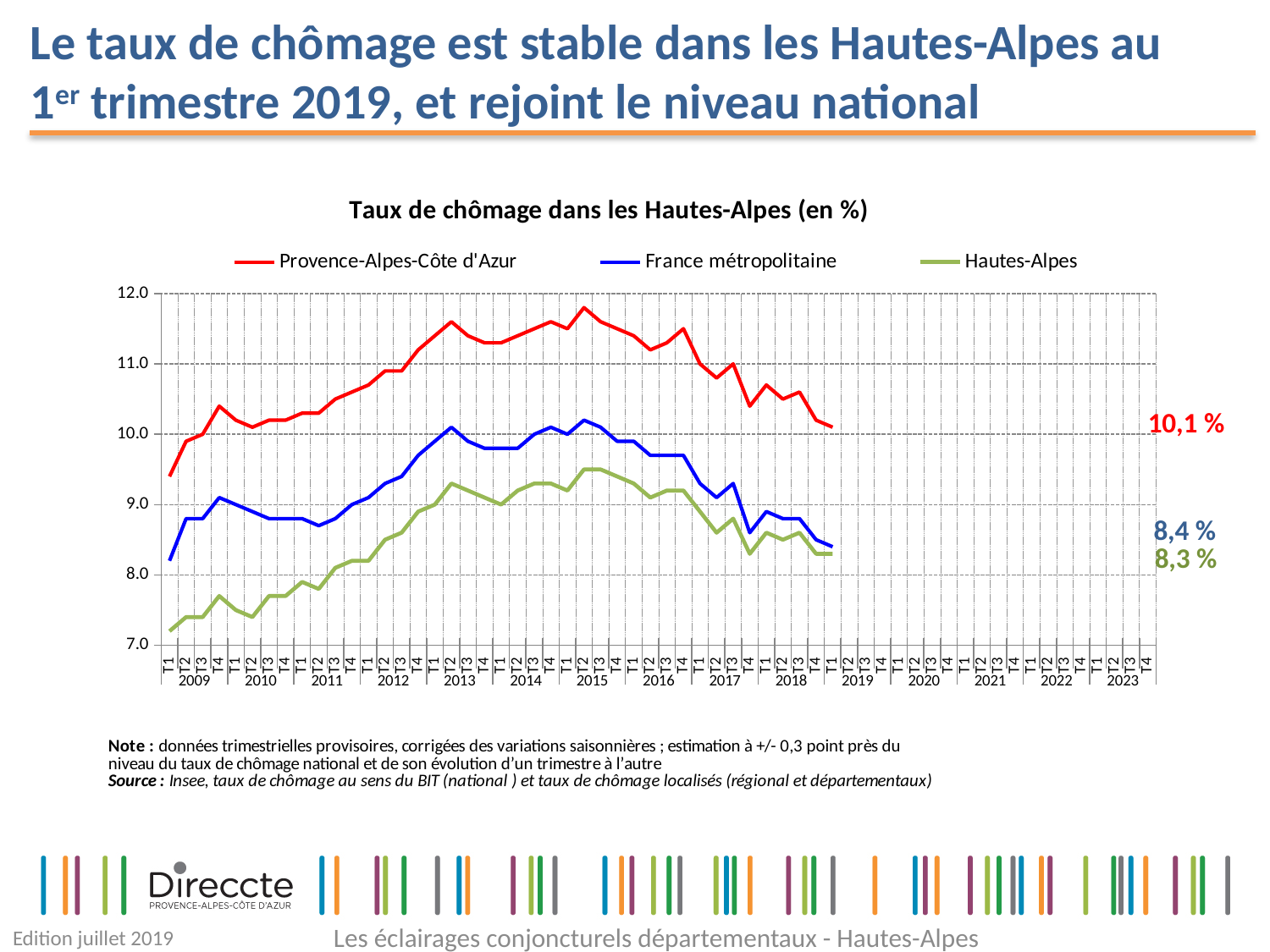
What is the difference between the labelled France métropolitaine rate and the labelled Hautes-Alpes rate at T1 2019? 0,1 point What is the unemployment rate labelled for France métropolitaine at the end of the series (T1 2019)? 8,4 % Is the value for Hautes-Alpes at T1 2009 greater or less than 8.0? less Does the Hautes-Alpes series rise or fall between 2015 and T1 2019? Fall Is the value for Provence-Alpes-Côte d'Azur at T2 2015 greater or less than 11.0? greater Which series has the highest values across the whole period shown? Provence-Alpes-Côte d'Azur By how many points does the labelled Provence-Alpes-Côte d'Azur rate exceed the labelled France métropolitaine rate at T1 2019? 1,7 points What kind of chart is shown on the slide? Line chart What is the unemployment rate labelled for Hautes-Alpes at the end of the series (T1 2019)? 8,3 % At T1 2019, which series has the lowest labelled value? Hautes-Alpes How many series does the legend list? 3 What is the unemployment rate labelled for Provence-Alpes-Côte d'Azur at the end of the series (T1 2019)? 10,1 %